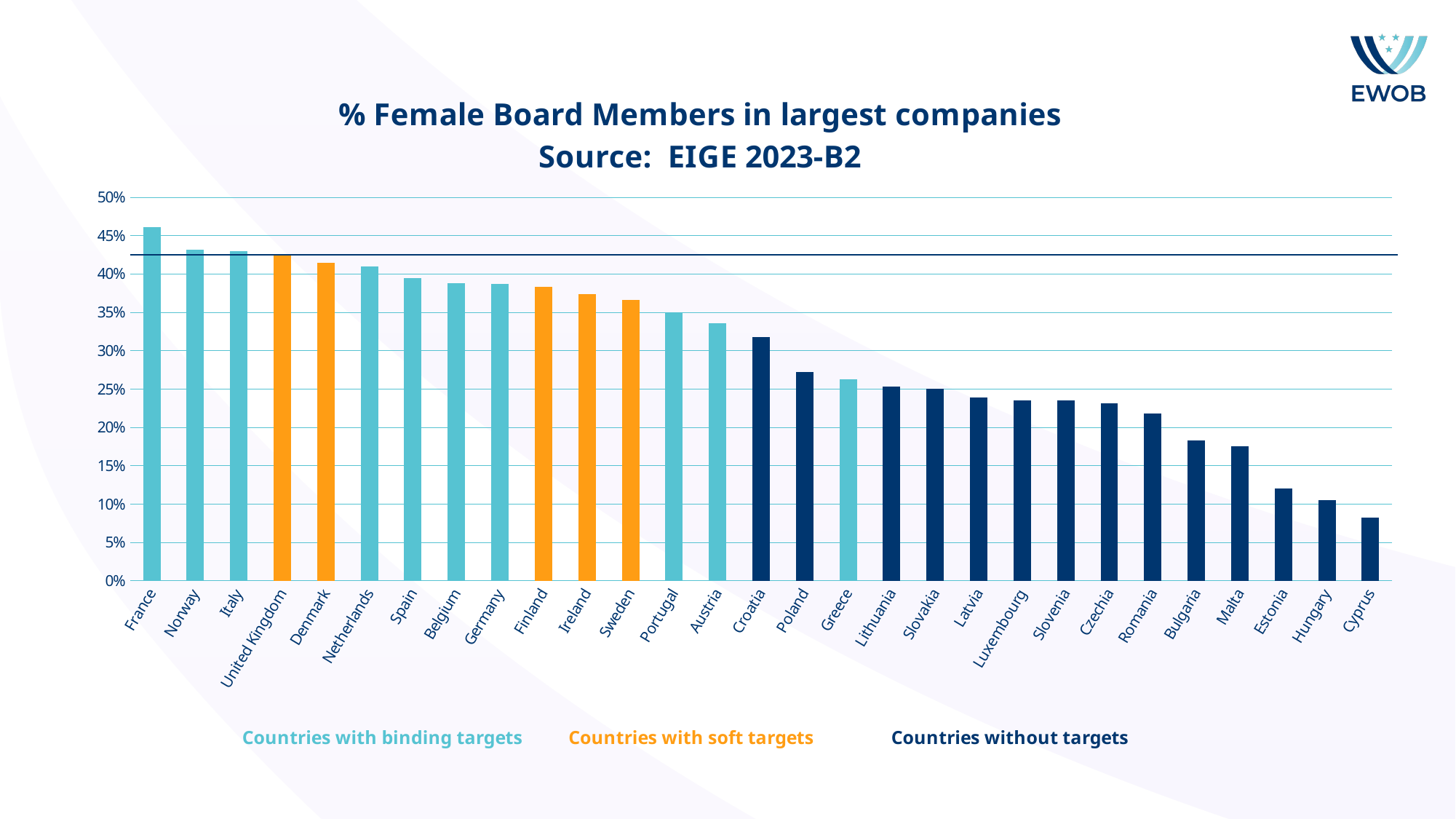
Do the values rise or fall moving from left to right along the x axis? fall Is the value for Bulgaria greater or less than 20%? less Which country has the highest percentage of female board members? France Which group of countries is shown in orange? Countries with soft targets Which is larger, the value for Croatia or the value for Poland? Croatia Is the value for France greater or less than 45%? greater Which country has the lowest percentage of female board members? Cyprus Is the value for Cyprus greater or less than 10%? less What kind of chart is shown on the slide? bar chart How many country groups does the legend list? 3 How many countries are shown on the chart? 29